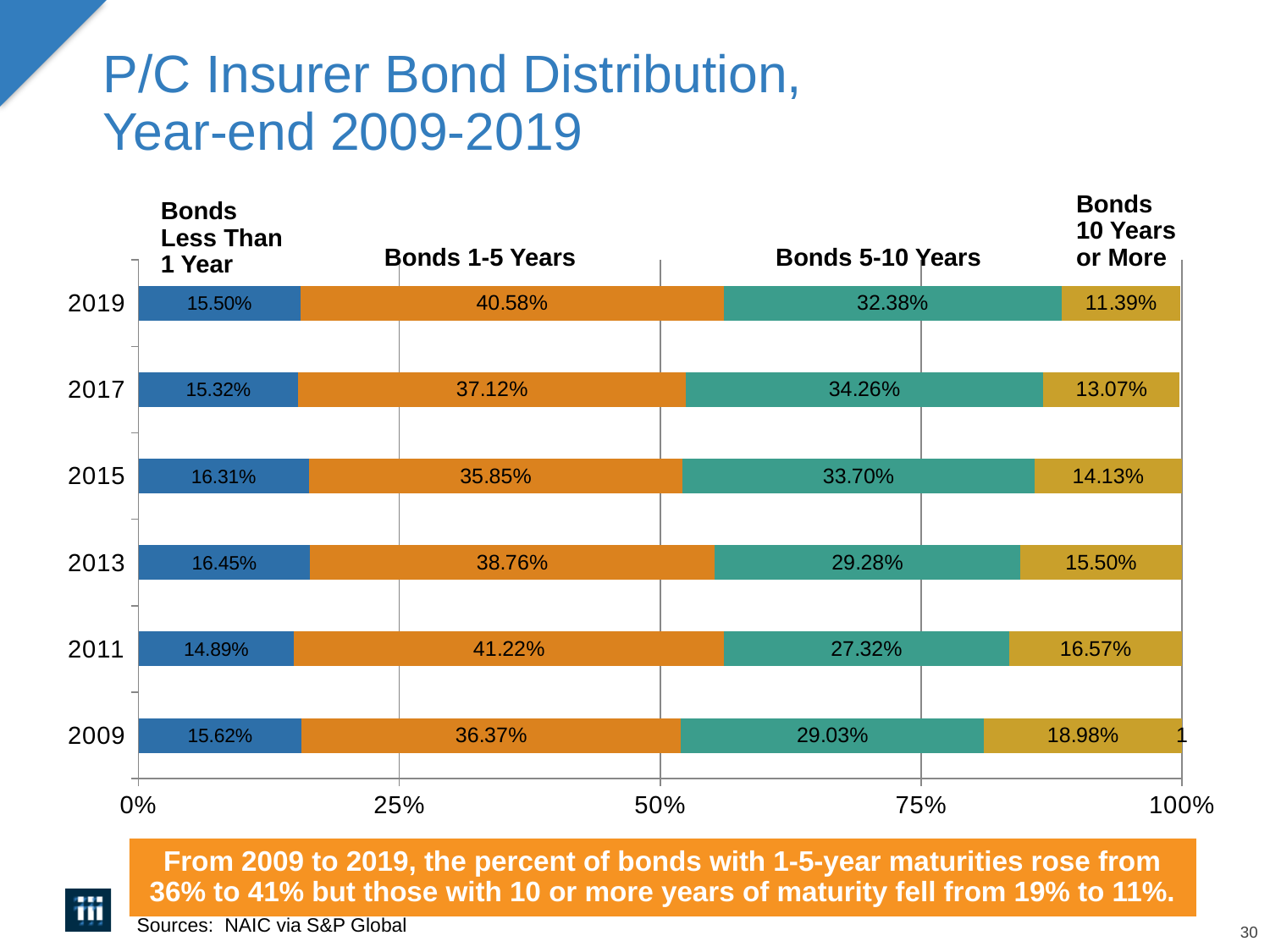
How many years are shown on the chart? 6 What is the value for Bonds 10 Years or More in 2009? 18.98% Which is larger, the Bonds 5-10 Years share in 2017 or in 2015? 2017 Does the share of Bonds 10 Years or More rise or fall from 2009 to 2019? Fall How many bond maturity categories (series) does the chart show? 4 In which year is the share of Bonds 10 Years or More the highest? 2009 What is the difference between the Bonds 5-10 Years share in 2019 and in 2009? 3.35 percentage points What kind of chart is shown on the slide? Stacked bar chart What is the value for Bonds 1-5 Years in 2019? 40.58% What is the value for Bonds 5-10 Years in 2013? 29.28% By how many percentage points did the share of Bonds 10 Years or More fall from 2009 to 2019? 7.59 percentage points In which year is the share of Bonds Less Than 1 Year the lowest? 2011